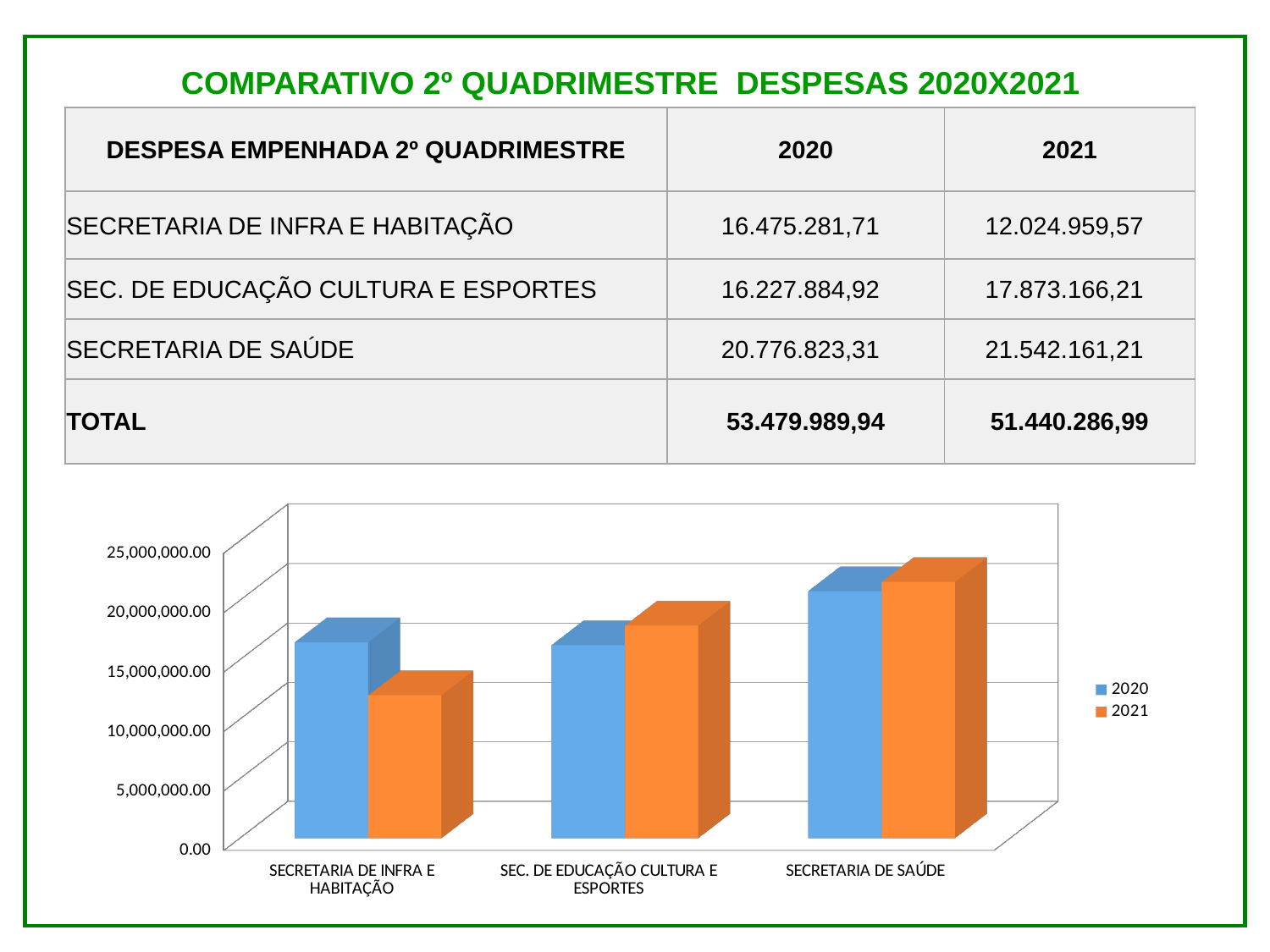
According to the table on the slide, what is the TOTAL for 2021? 51.440.286,99 Is the 2021 value for SECRETARIA DE SAÚDE greater or less than 20,000,000.00? greater Which category has the lowest 2021 bar in the chart? SECRETARIA DE INFRA E HABITAÇÃO For SECRETARIA DE INFRA E HABITAÇÃO, which bar is taller, 2020 or 2021? 2020 Which category has the highest 2020 bar in the chart? SECRETARIA DE SAÚDE How many categories are shown on the x axis of the chart? 3 How many series does the chart legend list? 2 What are the two entries listed in the chart legend? 2020 and 2021 According to the table on the slide, what is the 2020 value for SECRETARIA DE SAÚDE? 20.776.823,31 For SEC. DE EDUCAÇÃO CULTURA E ESPORTES, which bar is taller, 2020 or 2021? 2021 Is the 2021 value for SECRETARIA DE INFRA E HABITAÇÃO greater or less than 15,000,000.00? less What kind of chart is shown on the slide? bar chart